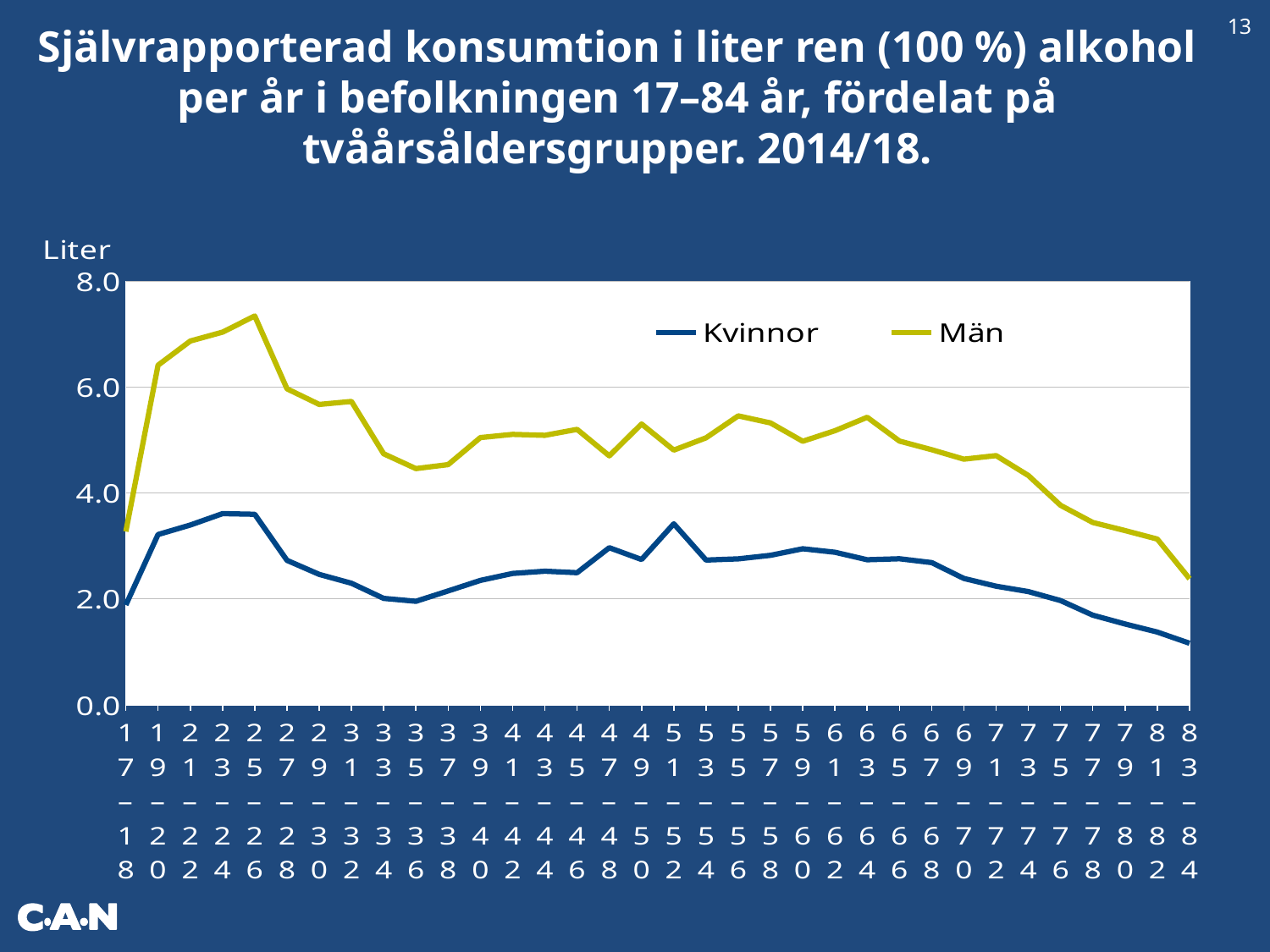
What kind of chart is shown on the slide? line chart How many series does the legend list? 2 Which series has the larger value in the 25–26 age group, Kvinnor or Män? Män For which age group is the value for Män lowest? 83–84 Which two series are listed in the legend? Kvinnor and Män What is the label on the y axis? Liter Does the value for Män rise or fall from the 65–66 age group to the 83–84 age group? fall For which age group is the value for Män highest? 25–26 Is the value for Kvinnor in the 83–84 age group greater or less than 2.0? less Is the value for Män in the 25–26 age group greater or less than 6.0? greater How many two-year age groups are plotted along the x axis? 34 For which age group is the value for Kvinnor lowest? 83–84